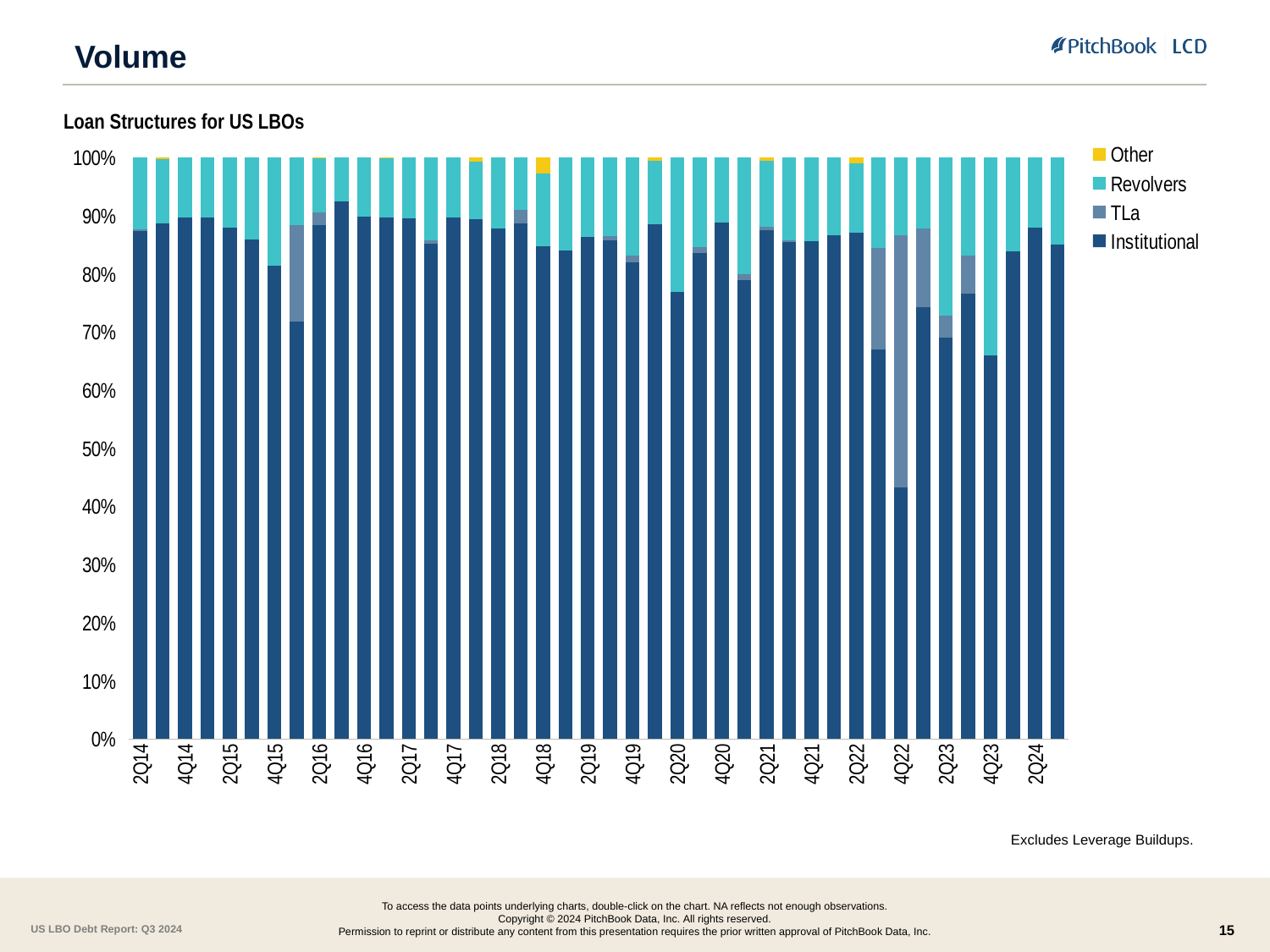
Is the Institutional share for 4Q22 greater or less than 50%? less What does each stacked bar total? 100% How many series does the legend list? 4 Which series is shown in yellow in the legend? Other Which labeled quarter has the lowest Institutional share? 4Q22 Is the Institutional share for 2Q14 greater or less than 80%? greater Which has the larger Institutional share, 4Q23 or 2Q24? 2Q24 Which has the larger Institutional share, 2Q14 or 4Q22? 2Q14 Is the Institutional share for 2Q20 greater or less than 80%? less What kind of chart is shown on the slide? Stacked bar chart What is the title of the chart? Loan Structures for US LBOs